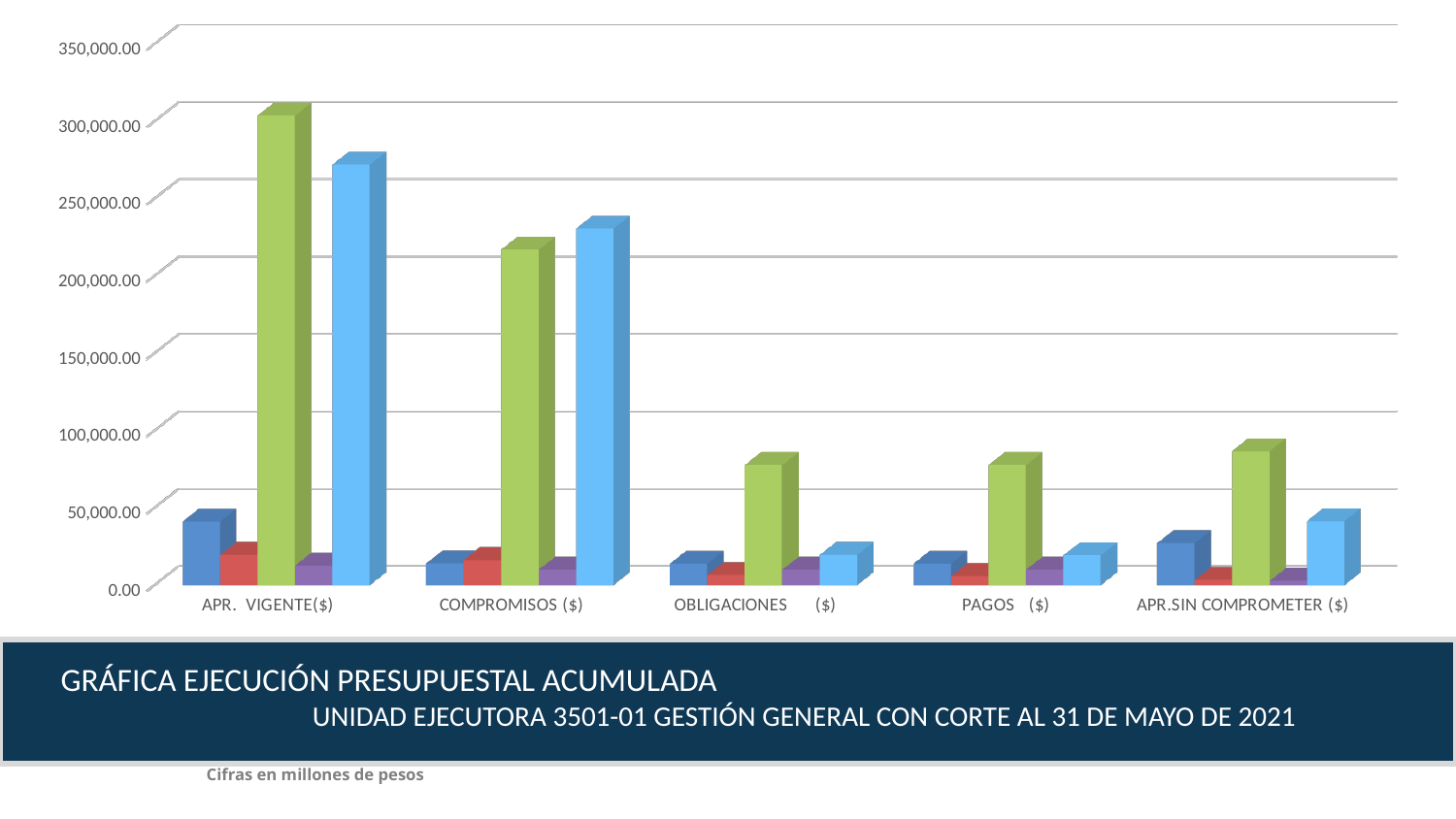
Is the value of the green bar for OBLIGACIONES ($) greater or less than 100,000.00? less Which category has the tallest green bar? APR. VIGENTE($) What is the highest value shown on the y axis of the chart? 350,000.00 How many categories are shown along the x axis of the chart? 5 According to the note below the chart, in what units are the figures expressed? Cifras en millones de pesos What kind of chart is shown on the slide? Bar chart Is the green bar larger for APR. VIGENTE($) or for COMPROMISOS ($)? APR. VIGENTE($) Is the value of the light blue bar for PAGOS ($) greater or less than 50,000.00? less Is the value of the green bar for COMPROMISOS ($) greater or less than 200,000.00? greater How many bars are plotted for each category in the chart? 5 For APR.SIN COMPROMETER ($), is the green bar or the light blue bar larger? Green bar